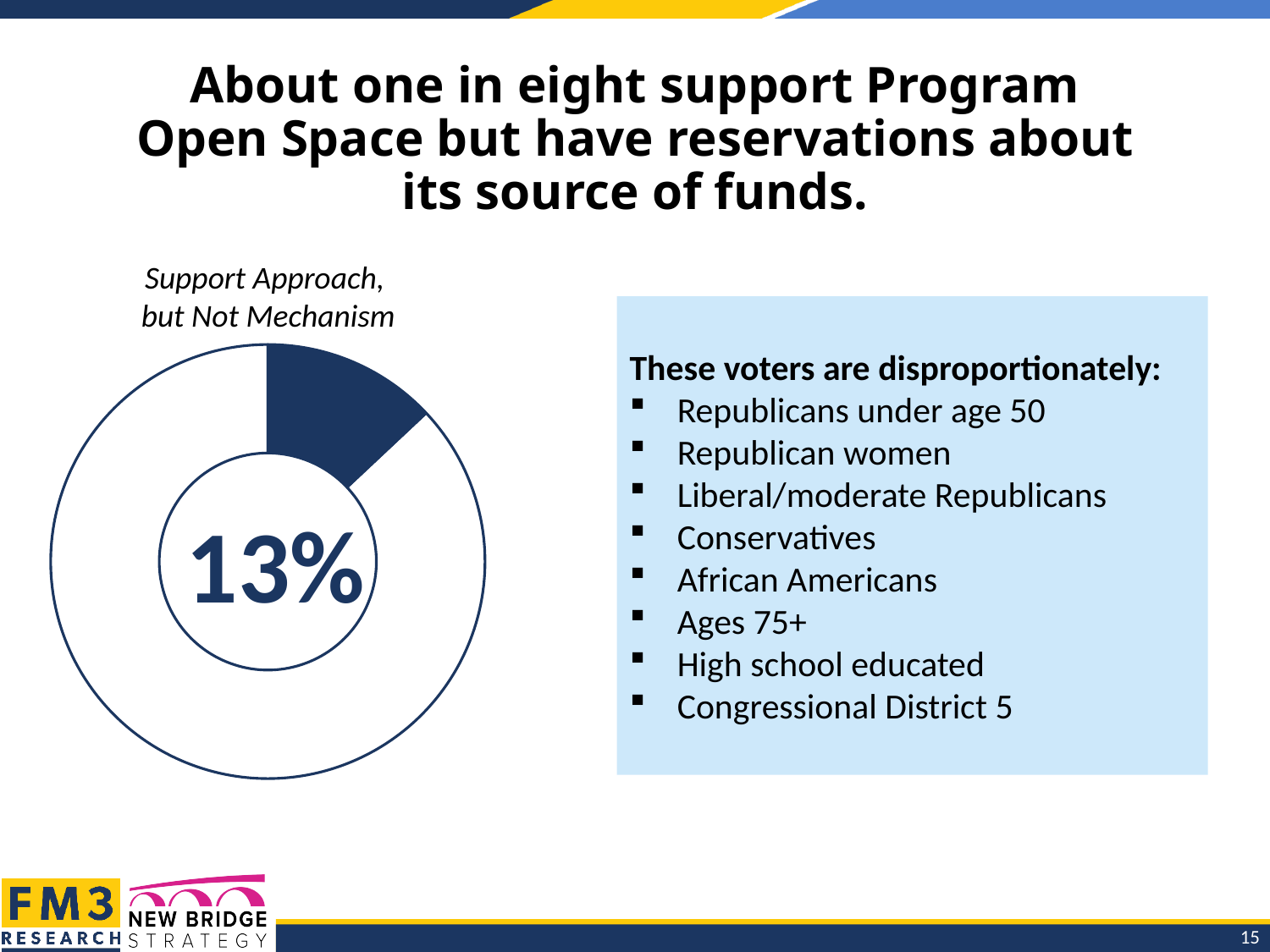
What is the title of the chart on the left of the slide? Support Approach, but Not Mechanism What kind of chart is shown on the left of the slide? Donut (pie) chart Is the value shown in the donut chart greater or less than 10%? greater Is the dark blue segment of the donut chart larger or smaller than the remaining white portion? Smaller How many segments does the donut chart show? 2 What percentage is shown in the center of the donut chart? 13% Is the value shown in the donut chart greater or less than 50%? less What colour is the filled segment of the donut chart? Dark blue What share of the donut chart does the dark blue segment represent? 13%